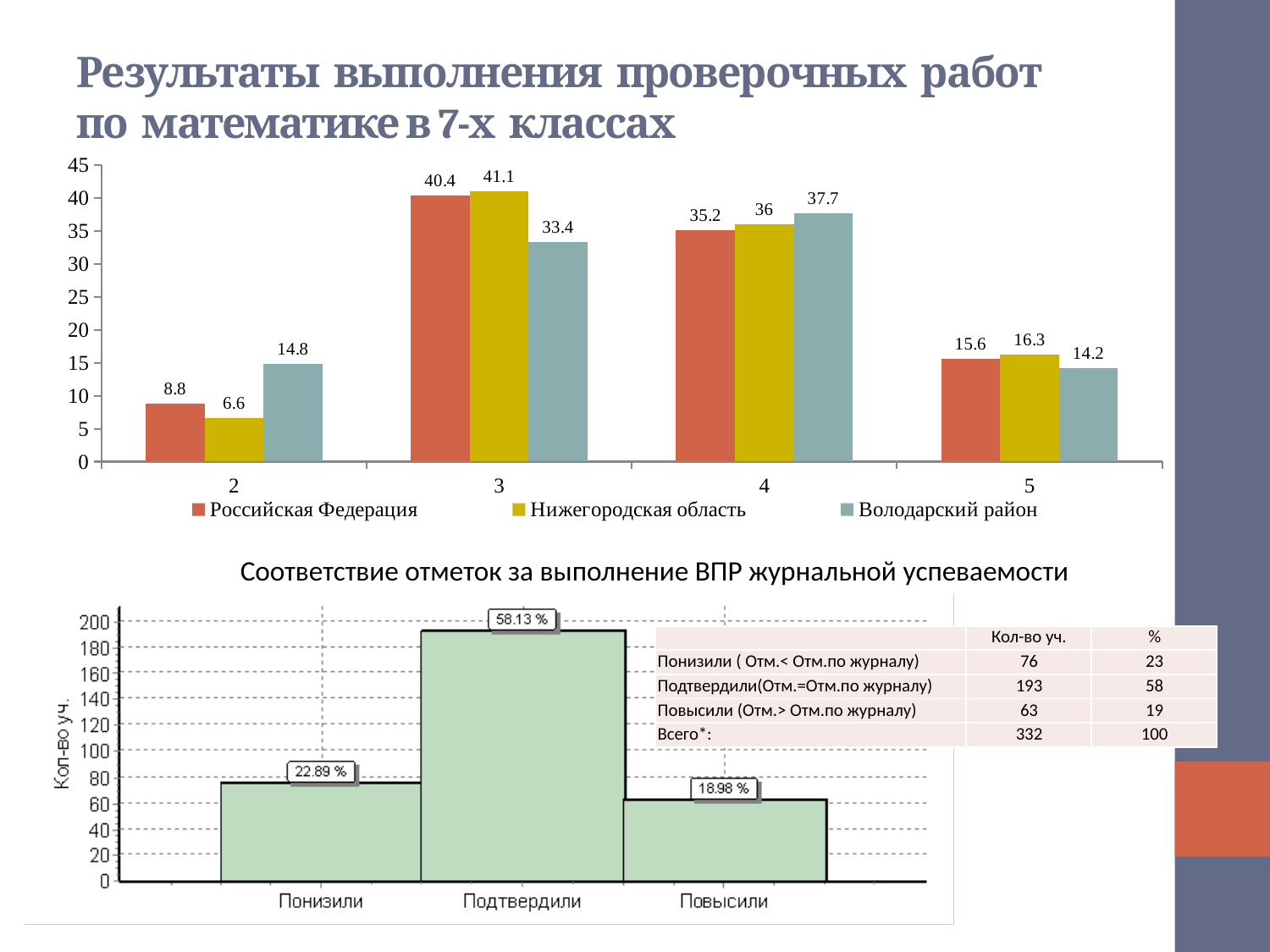
In the top chart, what is the value for Нижегородская область for category 5? 16.3 In the top chart, what is the value for Володарский район for category 3? 33.4 In the bottom chart, is the value for Повысили greater or less than 80? less In the top chart, which is larger for category 2: Володарский район or Нижегородская область? Володарский район In the bottom chart, what percentage label is shown on the Подтвердили bar? 58.13 % How many categories are shown on the x axis of the top chart? 4 In the top chart, what is the value for Российская Федерация for category 2? 8.8 In the top chart, what is the difference between Нижегородская область and Российская Федерация for category 4? 0.8 How many series does the legend of the top chart list? 3 In the top chart, which category has the lowest value for Российская Федерация? 2 In the top chart, which category has the highest value for Нижегородская область? 3 What kind of chart is the bottom chart titled 'Соответствие отметок за выполнение ВПР журнальной успеваемости'? bar chart